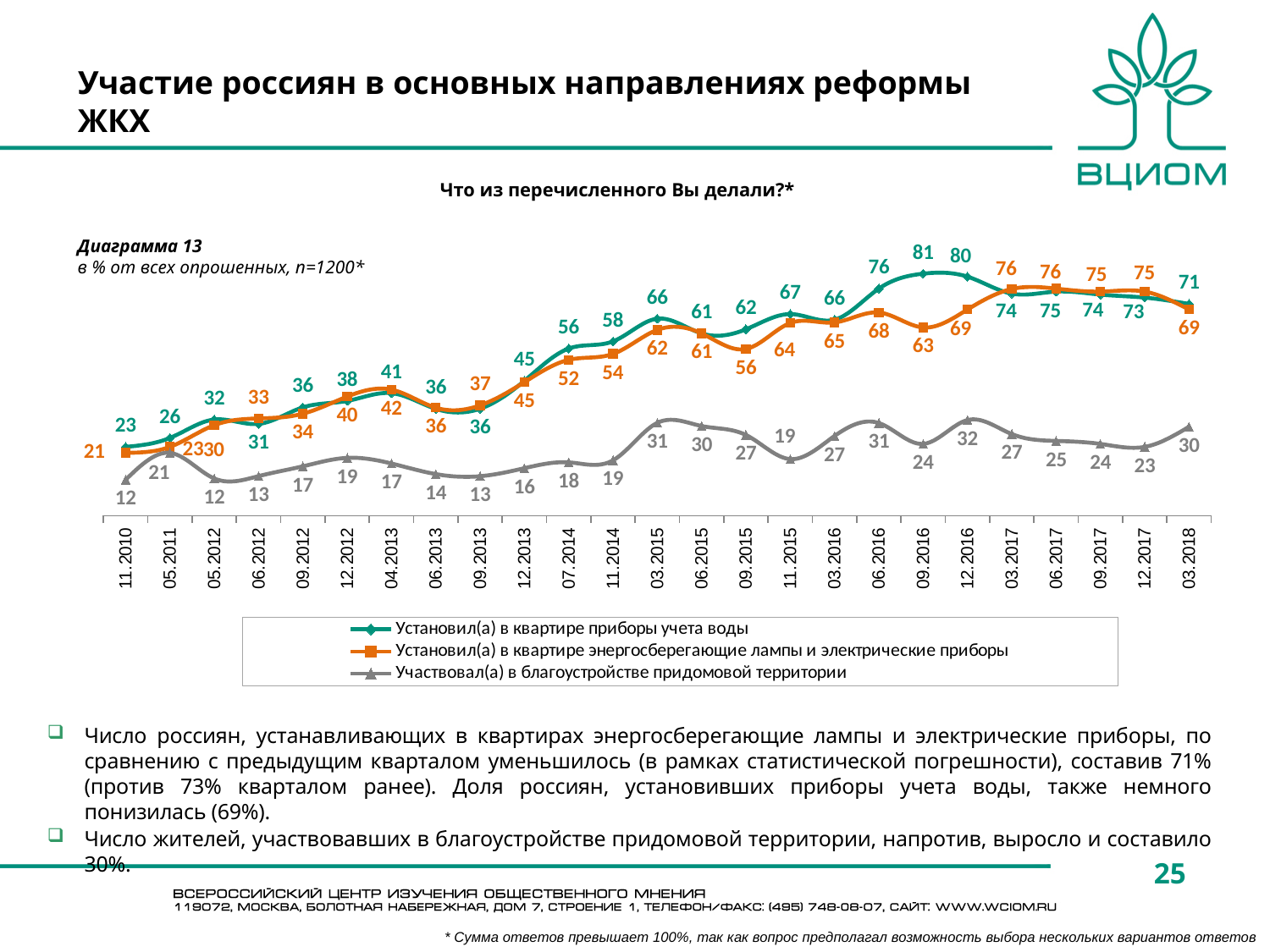
What is the value for 'Участвовал(а) в благоустройстве придомовой территории' in 03.2015? 31 What is the value for 'Установил(а) в квартире приборы учета воды' in 09.2016? 81 What question is shown as the chart's heading? Что из перечисленного Вы делали?* What is the lowest value of the series 'Установил(а) в квартире энергосберегающие лампы и электрические приборы', and in which period? 21, in 11.2010 How many time points are plotted along the x axis? 25 How many series does the legend list? 3 Does the series 'Установил(а) в квартире приборы учета воды' generally rise or fall from 11.2010 to 09.2016? Rise In which period does the series 'Установил(а) в квартире приборы учета воды' reach its highest value? 09.2016 What kind of chart is shown on the slide? Line chart What is the difference between 'Установил(а) в квартире приборы учета воды' (62) and 'Установил(а) в квартире энергосберегающие лампы и электрические приборы' (56) in 09.2015? 6 What is the value for 'Установил(а) в квартире энергосберегающие лампы и электрические приборы' in 12.2012? 40 In 12.2016, which is larger: the value for water meters or the value for energy-saving lamps? Water meters (80)